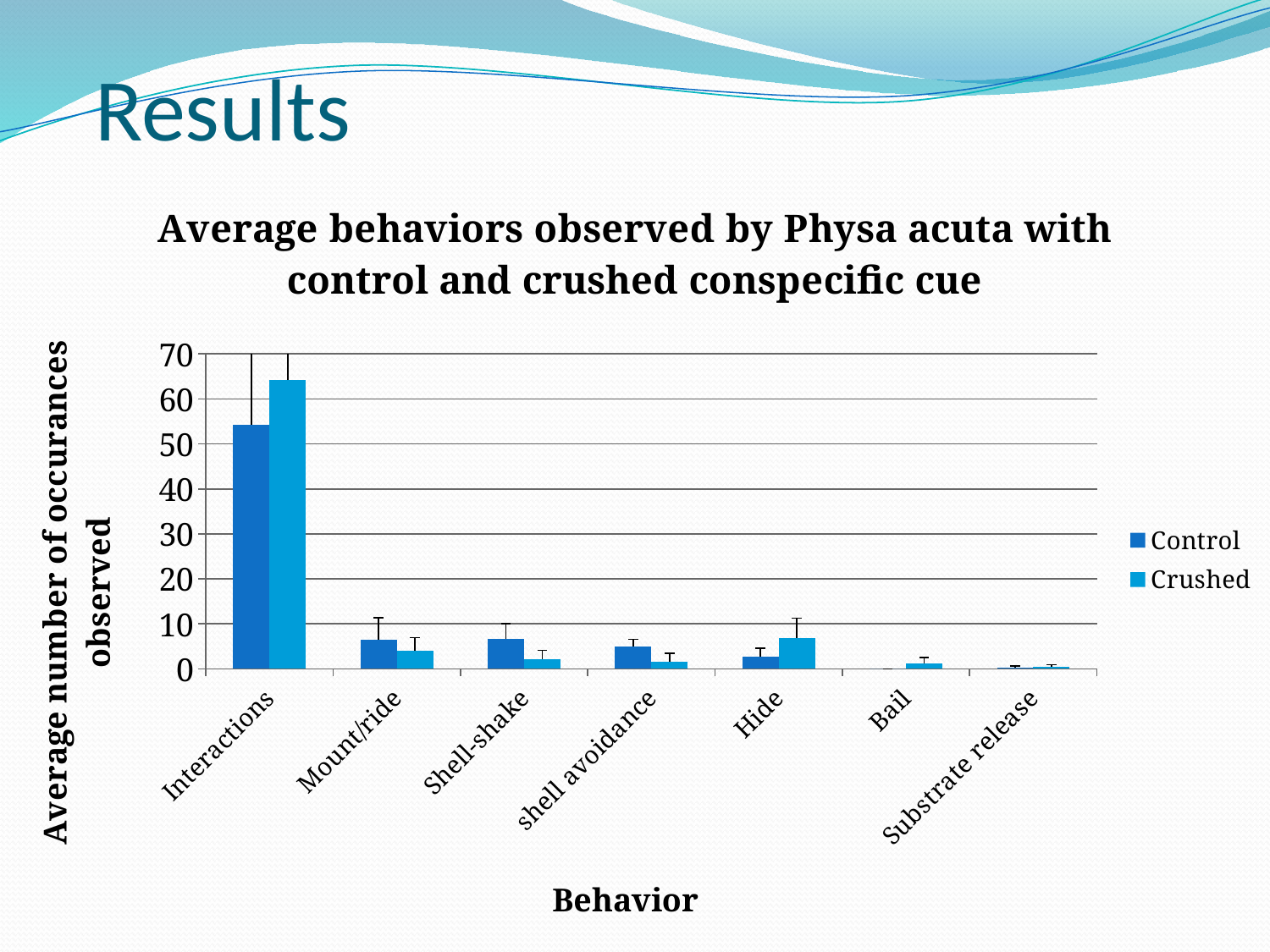
Is the Control value for Interactions greater or less than 50? greater Which behavior has the highest Crushed value? Interactions For Mount/ride, which is larger: the Control value or the Crushed value? Control Is the Control value for Shell-shake greater or less than 10? less Which behavior has the highest Control value? Interactions What kind of chart is shown on the slide? bar chart For Interactions, which is larger: the Control value or the Crushed value? Crushed Is the Crushed value for Interactions greater or less than 60? greater How many behavior categories are shown on the x axis? 7 For Hide, which is larger: the Control value or the Crushed value? Crushed What is the label on the y axis of the chart? Average number of occurances observed How many series does the legend list? 2